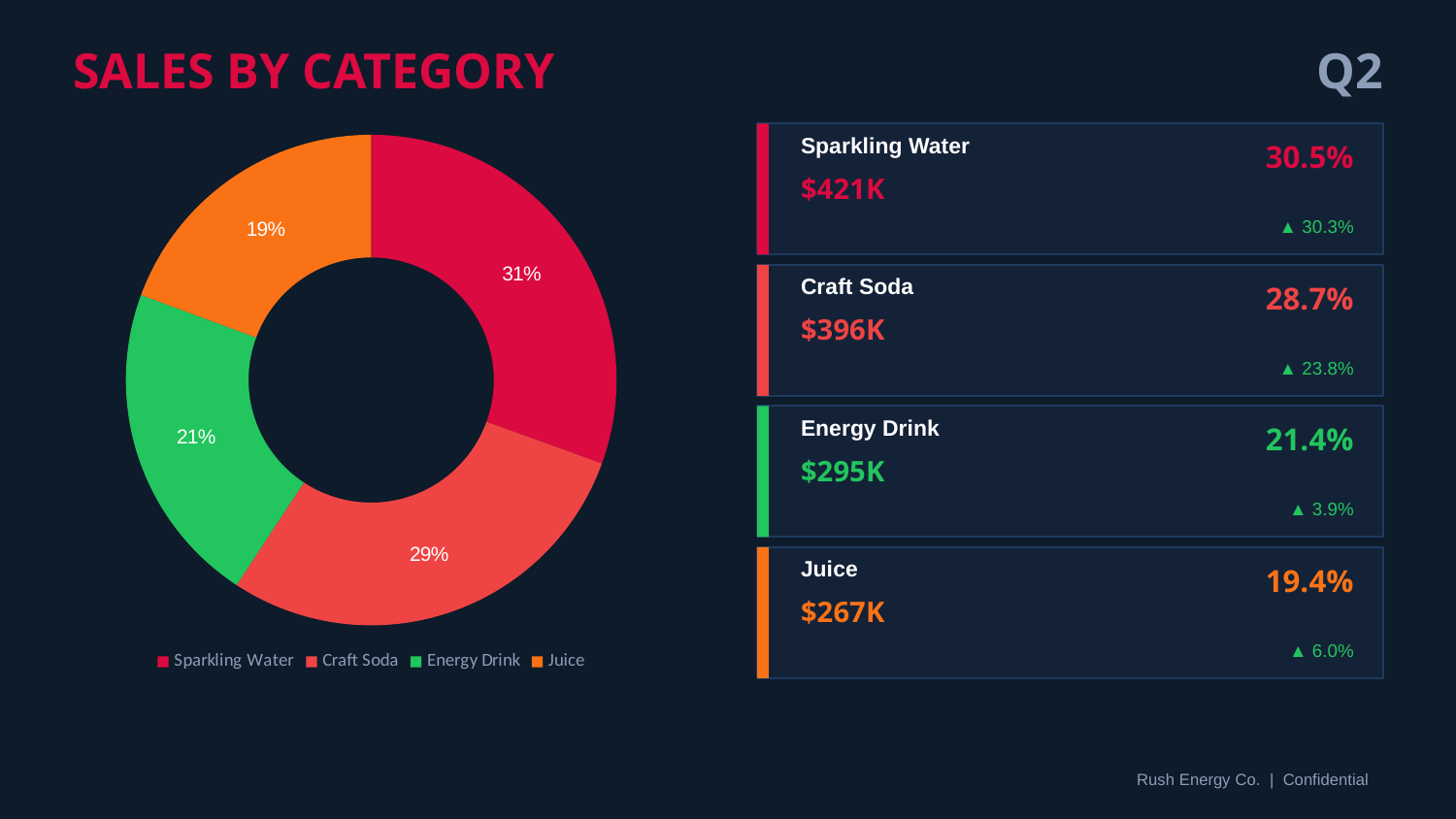
Which category has the smallest share of the pie chart? Juice Which category has the largest share of the pie chart? Sparkling Water Which slice is larger, Craft Soda or Energy Drink? Craft Soda What percentage of the pie chart does Juice account for? 19% What percentage of the pie chart does Energy Drink account for? 21% What percentage of the pie chart does Sparkling Water account for? 31% What is the difference in percentage points between the Sparkling Water and Juice slices? 12 What is the title of the chart on the slide? SALES BY CATEGORY What percentage of the pie chart does Craft Soda account for? 29% How many categories are shown in the pie chart? 4 What is the difference in percentage points between the Craft Soda and Energy Drink slices? 8 What type of chart is shown on the slide? Doughnut chart